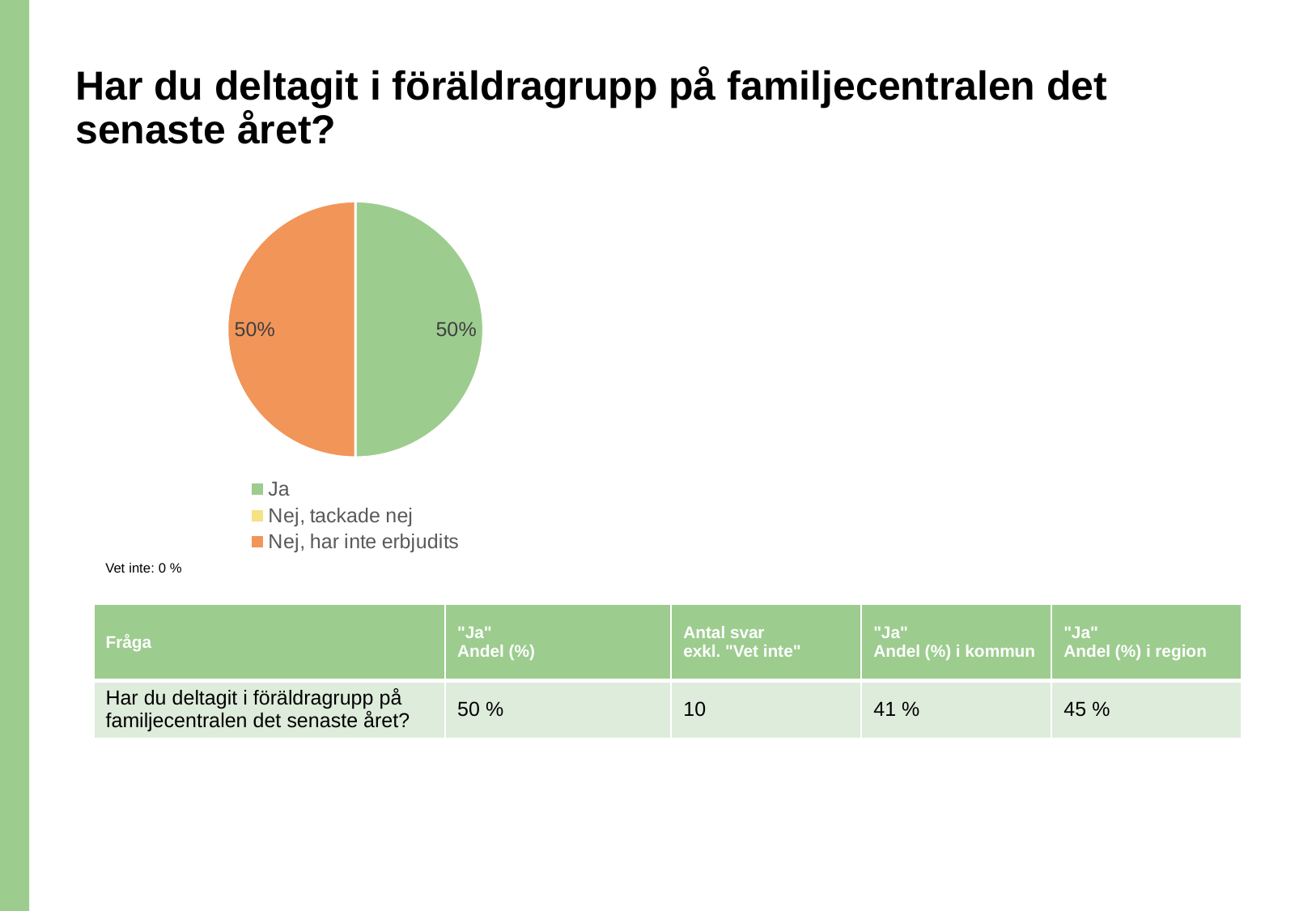
What percentage of the pie chart is labelled for "Ja"? 50% What is the difference between the "Ja" slice and the "Nej, har inte erbjudits" slice in the pie chart? 0% What share of the pie does the "Ja" slice represent? 50% What colour is the "Ja" slice in the pie chart? green What kind of chart is shown on the slide? pie chart How many entries does the legend of the pie chart list? 3 How many slices are visible in the pie chart? 2 What percentage of the pie chart is labelled for "Nej, har inte erbjudits"? 50% Which legend entry of the pie chart is shown in orange? Nej, har inte erbjudits